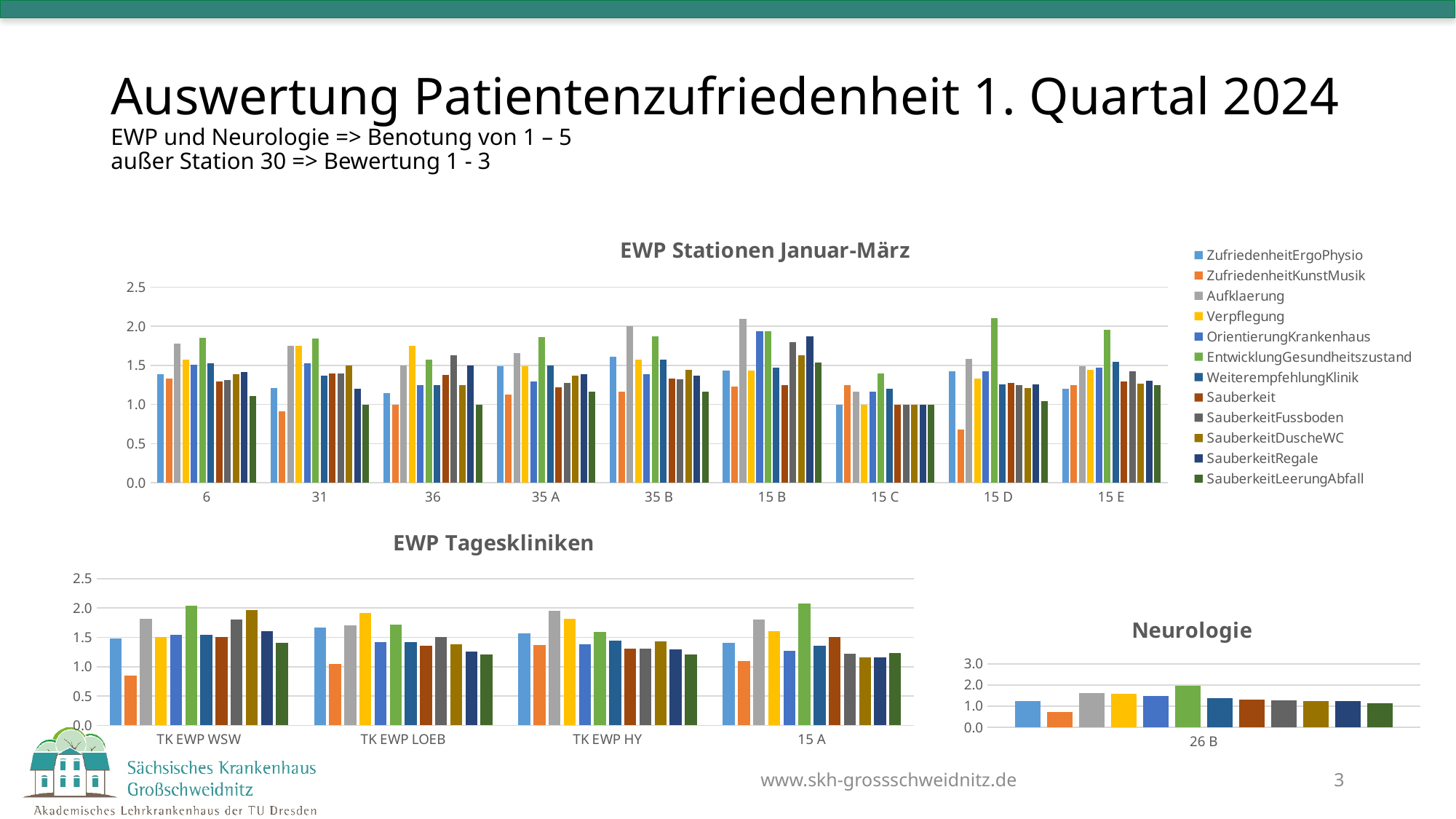
How many station categories are shown on the x axis of the "EWP Stationen Januar-März" chart? 9 What is the only category shown on the x axis of the "Neurologie" chart? 26 B In the "EWP Stationen Januar-März" chart, which is larger for station 15 D: ZufriedenheitErgoPhysio or ZufriedenheitKunstMusik? ZufriedenheitErgoPhysio In the "EWP Stationen Januar-März" chart, is the value of EntwicklungGesundheitszustand for station 15 D greater or less than 2.0? greater In the "EWP Stationen Januar-März" chart, is the value of ZufriedenheitKunstMusik for station 15 D greater or less than 1.0? less In the "Neurologie" chart, which series has the lowest value for 26 B? ZufriedenheitKunstMusik How many series does the legend of the "EWP Stationen Januar-März" chart list? 12 In the "EWP Tageskliniken" chart, which series has the lowest value for TK EWP WSW? ZufriedenheitKunstMusik What kind of chart is the "EWP Stationen Januar-März" chart? bar chart In the "EWP Tageskliniken" chart, is the value of ZufriedenheitKunstMusik for TK EWP WSW greater or less than 1.0? less How many categories are shown on the x axis of the "EWP Tageskliniken" chart? 4 In the "EWP Tageskliniken" chart, which series has the highest value for 15 A? EntwicklungGesundheitszustand